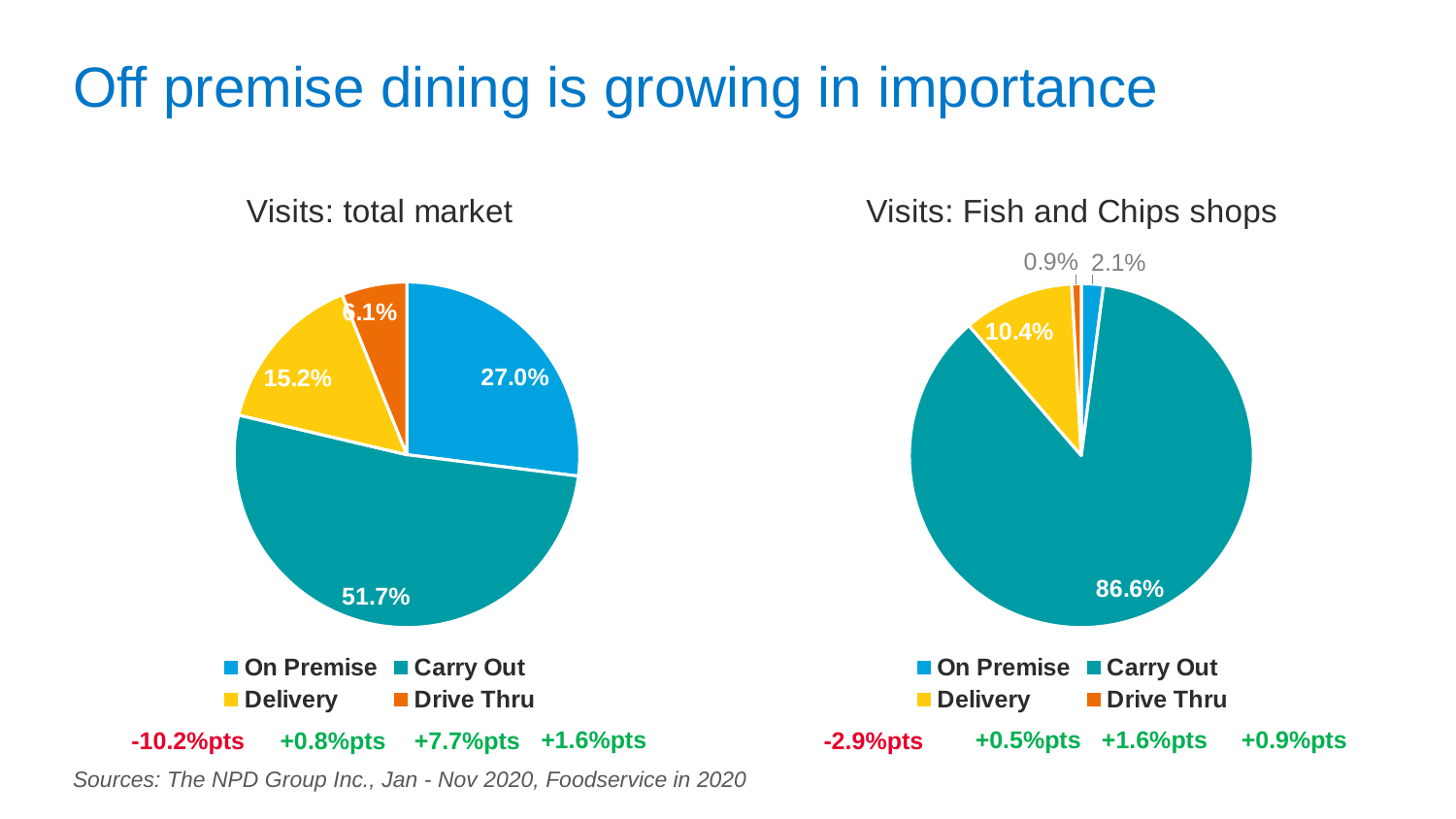
In the 'Visits: total market' chart, what share of visits is Carry Out? 51.7% Which chart has the larger Delivery share, 'Visits: total market' or 'Visits: Fish and Chips shops'? Visits: total market In the 'Visits: total market' chart, what share of visits is Delivery? 15.2% In the 'Visits: total market' chart, what share of visits is On Premise? 27.0% In the 'Visits: Fish and Chips shops' chart, what share of visits is Carry Out? 86.6% How many categories does the legend of the 'Visits: Fish and Chips shops' chart list? 4 In the 'Visits: total market' chart, which category has the largest share? Carry Out In the 'Visits: Fish and Chips shops' chart, what share of visits is Delivery? 10.4% What kind of chart is used for 'Visits: total market'? Pie chart In the 'Visits: Fish and Chips shops' chart, which category has the smallest share? Drive Thru In the 'Visits: total market' chart, what is the difference between the Carry Out and On Premise shares? 24.7 percentage points In the 'Visits: Fish and Chips shops' chart, what share of visits is On Premise? 2.1%